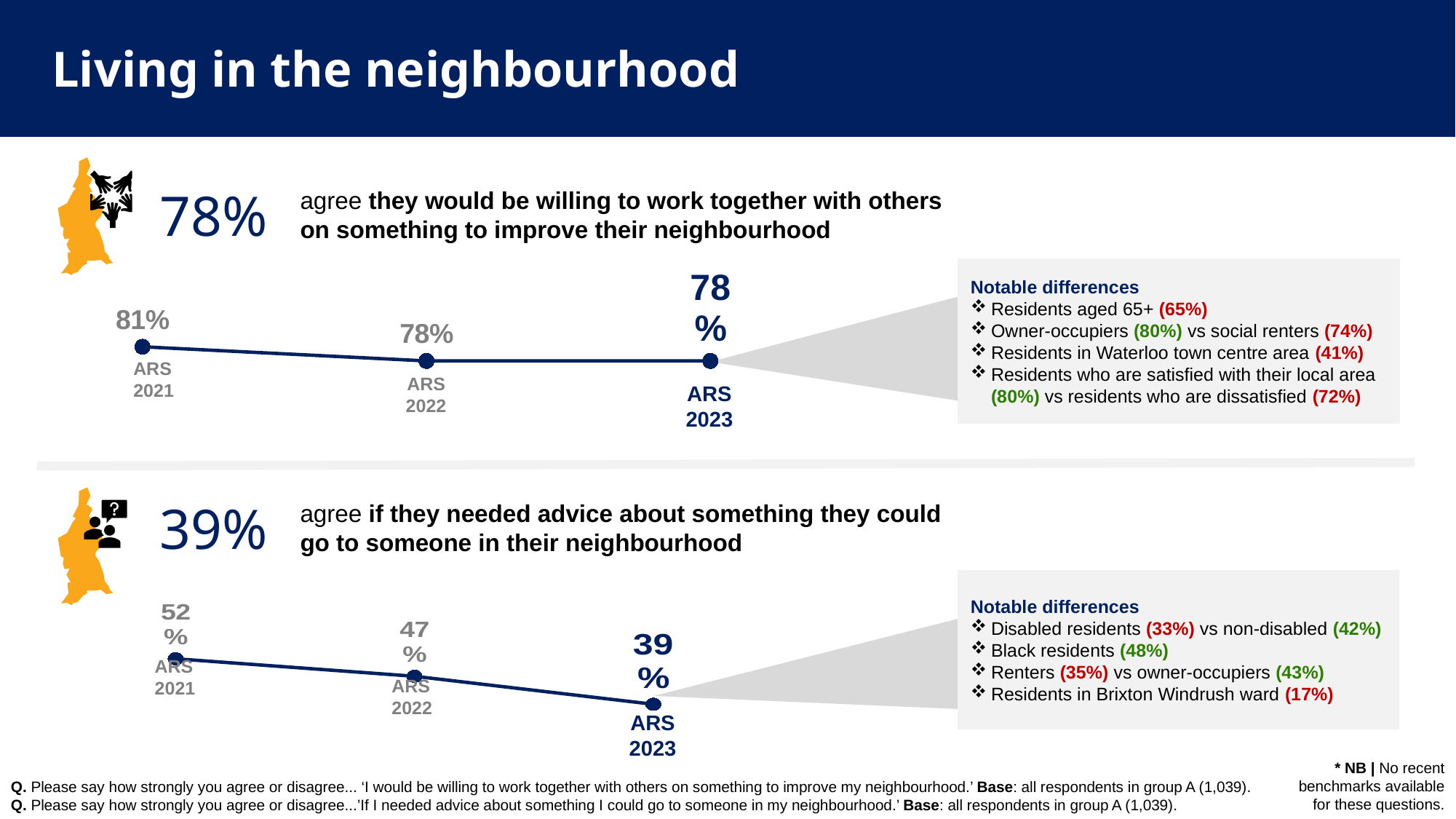
In the top chart (willing to work together with others), which year has the highest value? ARS 2021 What kind of chart is the top chart (willing to work together with others)? Line chart In the bottom chart (could go to someone in their neighbourhood for advice), what is the value for ARS 2022? 47% In the top chart (willing to work together with others to improve their neighbourhood), what is the value for ARS 2021? 81% In the bottom chart (advice from someone in the neighbourhood), what is the difference between the ARS 2021 and ARS 2023 values? 13 percentage points In the bottom chart (could go to someone in their neighbourhood for advice), what is the value for ARS 2023? 39% In the bottom chart (advice from someone in the neighbourhood), is the value for ARS 2021 or ARS 2022 larger? ARS 2021 How many data points are plotted in the bottom chart (advice from someone in the neighbourhood)? 3 In the top chart (willing to work together with others), what is the value for ARS 2023? 78% In the bottom chart (advice from someone in the neighbourhood), which year has the lowest value? ARS 2023 In the top chart (willing to work together with others), what is the difference between the ARS 2021 and ARS 2022 values? 3 percentage points In the bottom chart (advice from someone in the neighbourhood), which year has the highest value? ARS 2021